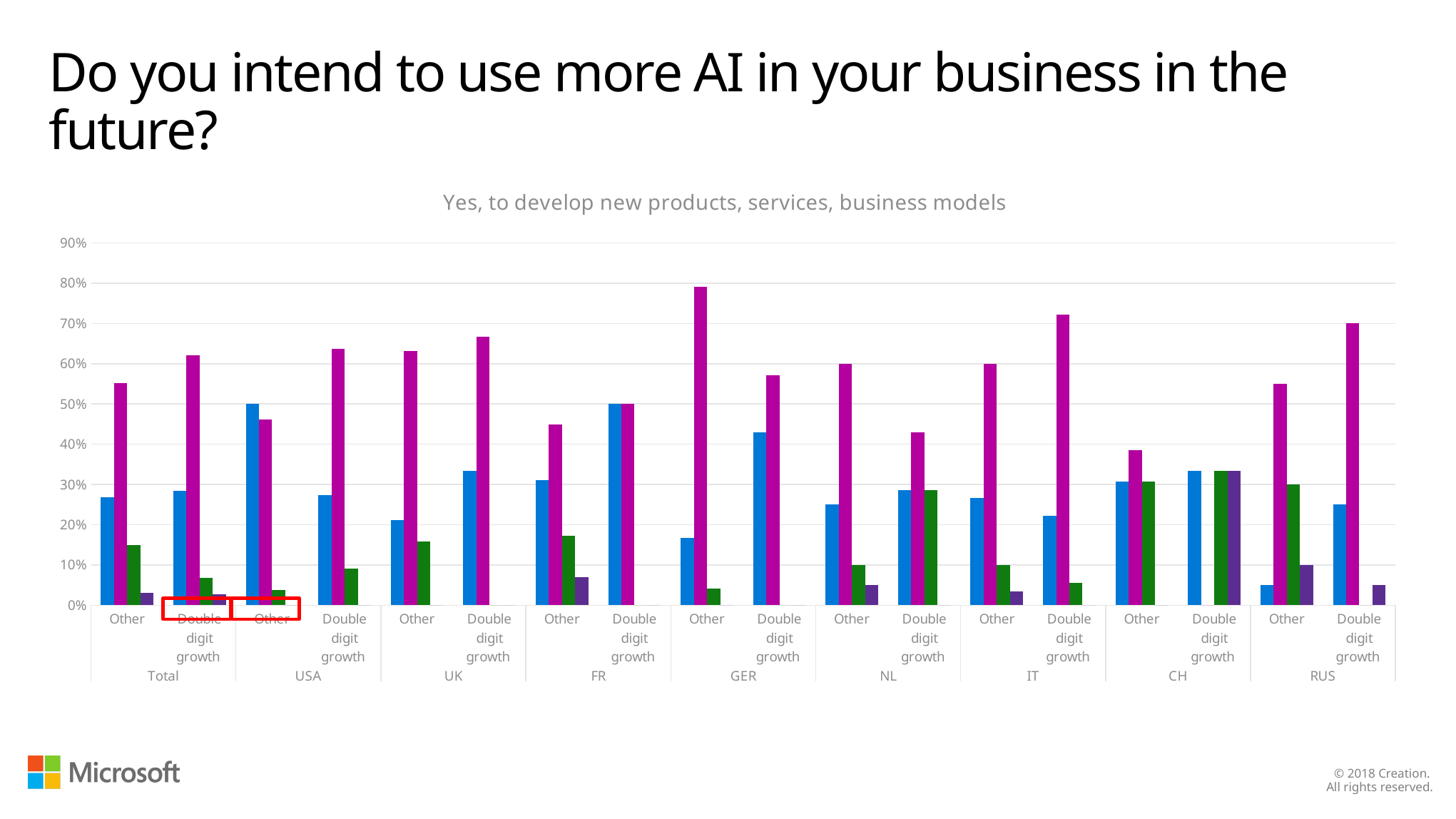
In the Total Other group, which is taller: the blue bar or the green bar? blue bar What is the title of the chart? Yes, to develop new products, services, business models How many country groups (including Total) are shown along the x axis? 9 Is the blue bar for USA Other greater or less than 40%? greater How many category labels (Other / Double digit growth) are there along the x axis in total? 18 Is the magenta bar for IT Double digit growth greater or less than 60%? greater Is the magenta bar for GER Other greater or less than 70%? greater In which country group does the magenta series reach its highest value? GER In the RUS Other group, which is taller: the green bar or the blue bar? green bar What kind of chart is shown on the slide? bar chart